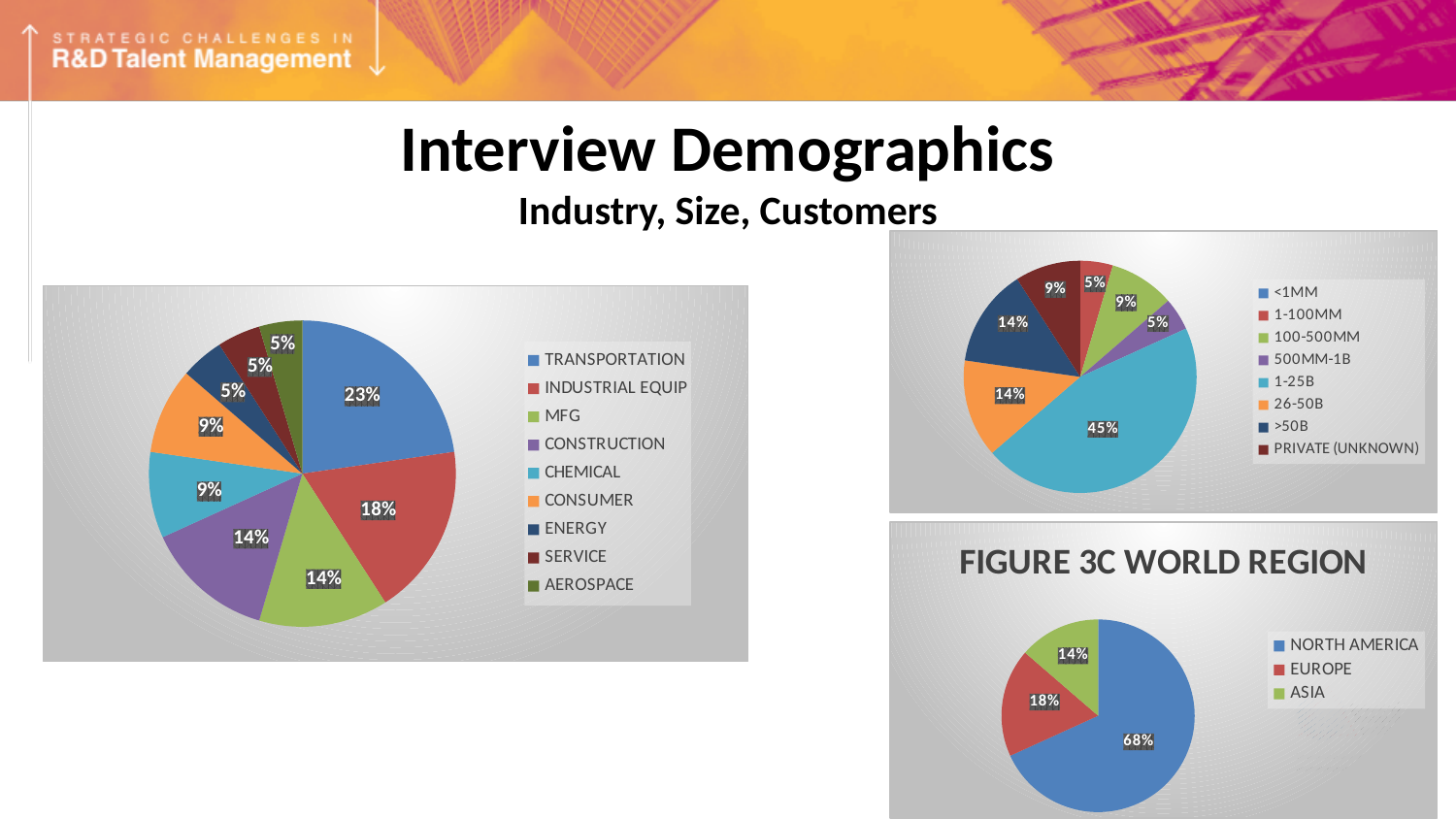
On the left industry pie chart, what share is TRANSPORTATION? 23% On the FIGURE 3C WORLD REGION chart, what share is NORTH AMERICA? 68% What type of chart is FIGURE 3C WORLD REGION? Pie chart On the top-right company size pie chart, how many entries does the legend list? 8 On the left industry pie chart, what share is INDUSTRIAL EQUIP? 18% On the left industry pie chart, which category has the largest share? TRANSPORTATION On the FIGURE 3C WORLD REGION chart, what is the difference between the EUROPE and ASIA shares? 4% On the left industry pie chart, how many categories does the legend list? 9 On the left industry pie chart, what is the difference between the TRANSPORTATION and CHEMICAL shares? 14% On the top-right company size pie chart, which category has the largest share? 1-25B On the top-right company size pie chart, what share is 1-25B? 45% On the left industry pie chart, which is larger, CONSTRUCTION or CONSUMER? CONSTRUCTION